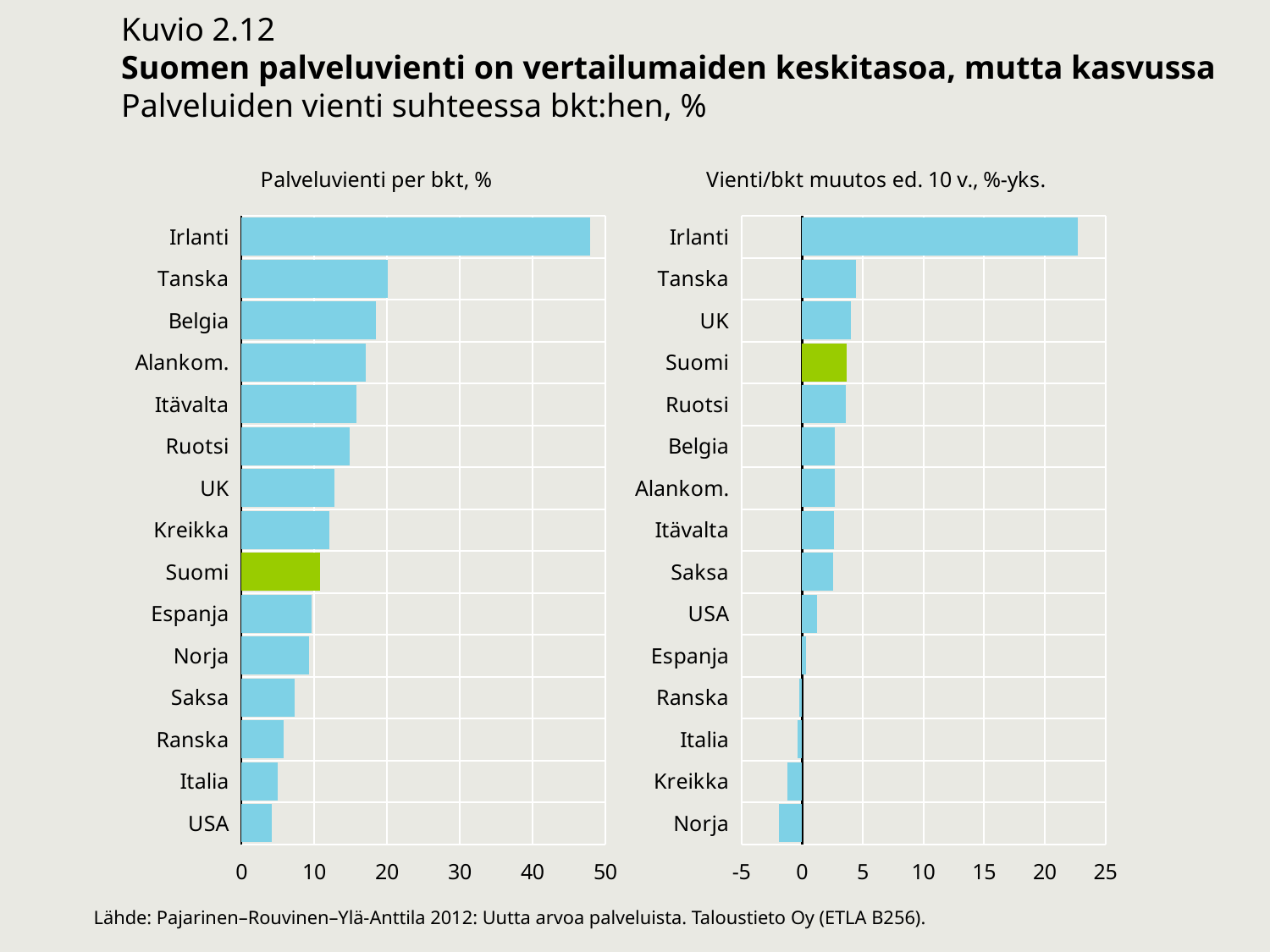
In the right chart "Vienti/bkt muutos ed. 10 v., %-yks.", which country has the highest value? Irlanti In the left chart "Palveluvienti per bkt, %", which country has the lowest value? USA In the left chart "Palveluvienti per bkt, %", which has the larger value, Tanska or Ruotsi? Tanska In the right chart "Vienti/bkt muutos ed. 10 v., %-yks.", which country has the lowest value? Norja In the right chart "Vienti/bkt muutos ed. 10 v., %-yks.", is the value for Irlanti greater or less than 20? greater In the left chart "Palveluvienti per bkt, %", which country has the highest value? Irlanti In the left chart "Palveluvienti per bkt, %", how many countries are shown? 15 In the left chart "Palveluvienti per bkt, %", is the value for Belgia greater or less than 20? less In the right chart "Vienti/bkt muutos ed. 10 v., %-yks.", how many countries are shown? 15 In both charts, which country's bar is highlighted in green? Suomi What kind of chart is the left chart titled "Palveluvienti per bkt, %"? bar chart In the left chart "Palveluvienti per bkt, %", is the value for Irlanti greater or less than 40? greater